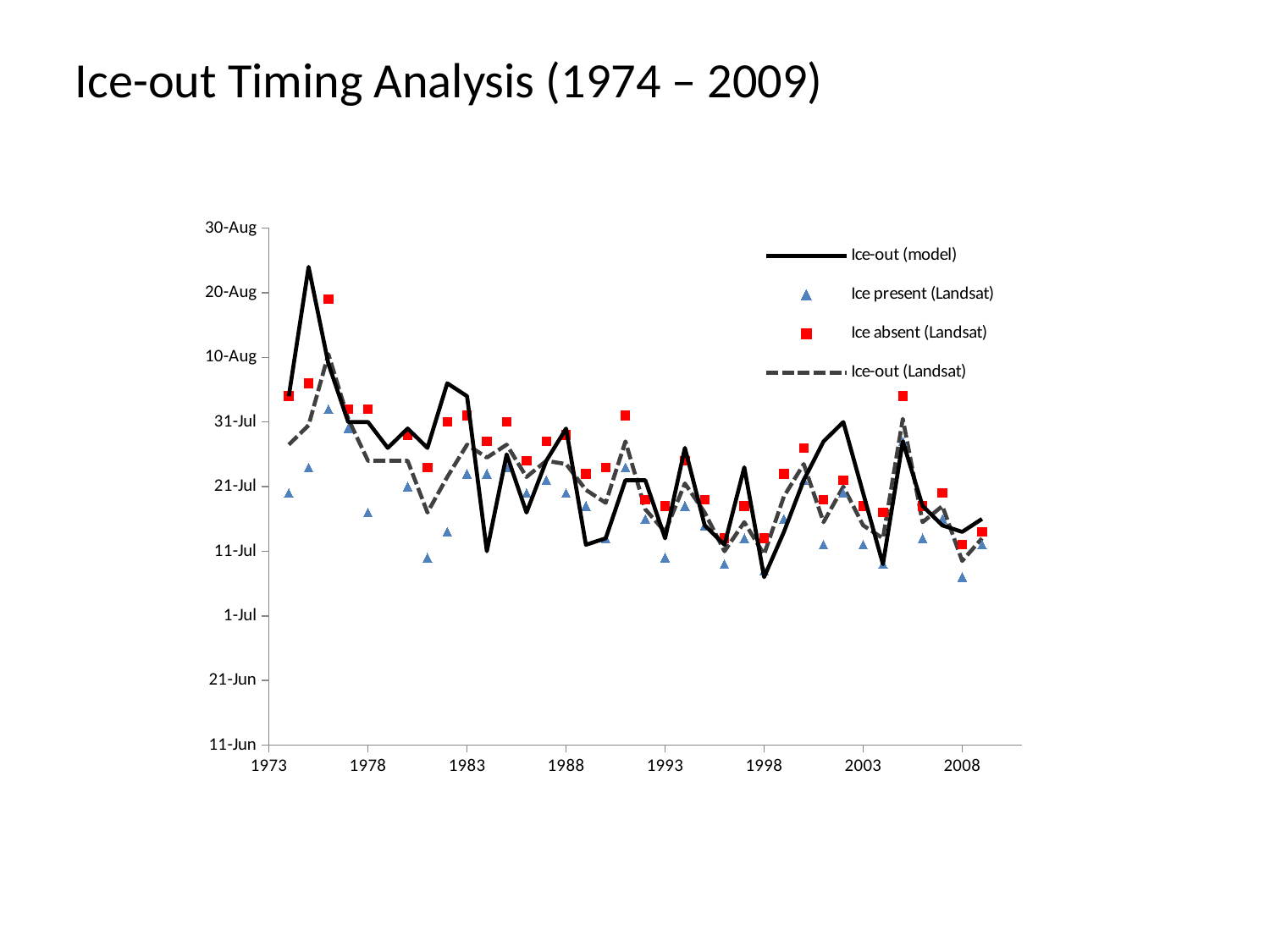
What is the title of the slide containing the chart? Ice-out Timing Analysis (1974 – 2009) Which series in the legend is drawn as a dashed line? Ice-out (Landsat) Overall, does the Ice-out (model) line rise or fall from 1975 to 2009? fall Is the Ice-out (model) value for 1975 greater or less than 20-Aug? greater Which is larger, the Ice-out (model) value for 1975 or for 2002? 1975 In which year does the Ice-out (model) line reach its highest value? 1975 Is the Ice-out (model) value for 1998 greater or less than 11-Jul? less How many series does the chart legend list? 4 Is the Ice absent (Landsat) value for 1976 greater or less than 10-Aug? greater How many year labels are shown on the x axis? 8 What kind of chart is shown on the slide? line chart